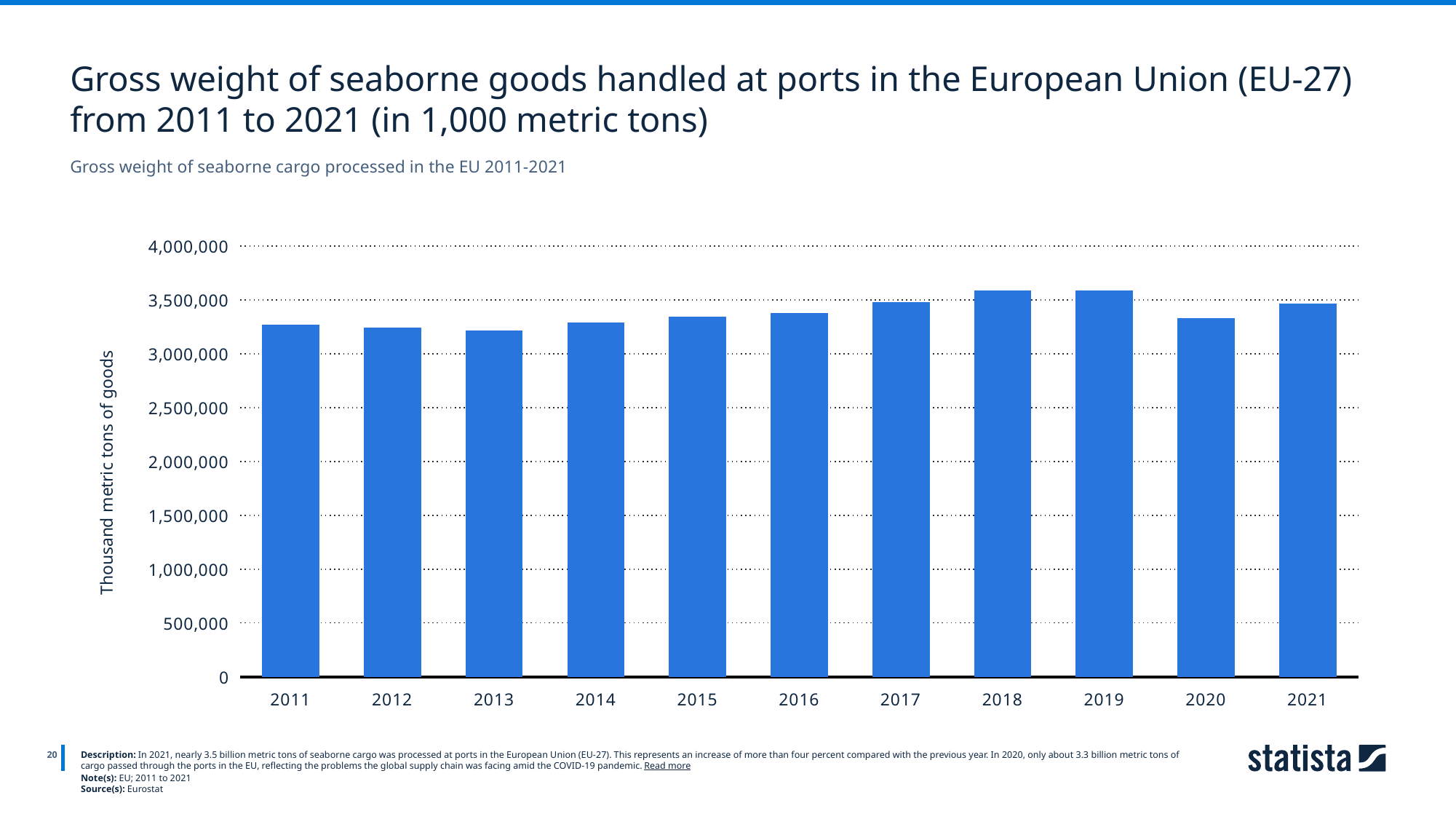
Is the value for 2018 greater or less than 3,500,000? greater What source is cited for the chart data? Eurostat Is the value for 2020 greater or less than 3,500,000? less What is the label on the vertical axis? Thousand metric tons of goods How many years are plotted on the chart? 11 Which year has the larger value, 2013 or 2018? 2018 What kind of chart is shown on the slide? Bar chart Which year has the larger value, 2020 or 2021? 2021 Which year has the larger value, 2019 or 2020? 2019 Is the value for 2011 greater or less than 3,000,000? greater Do the values rise or fall from 2013 to 2018? rise